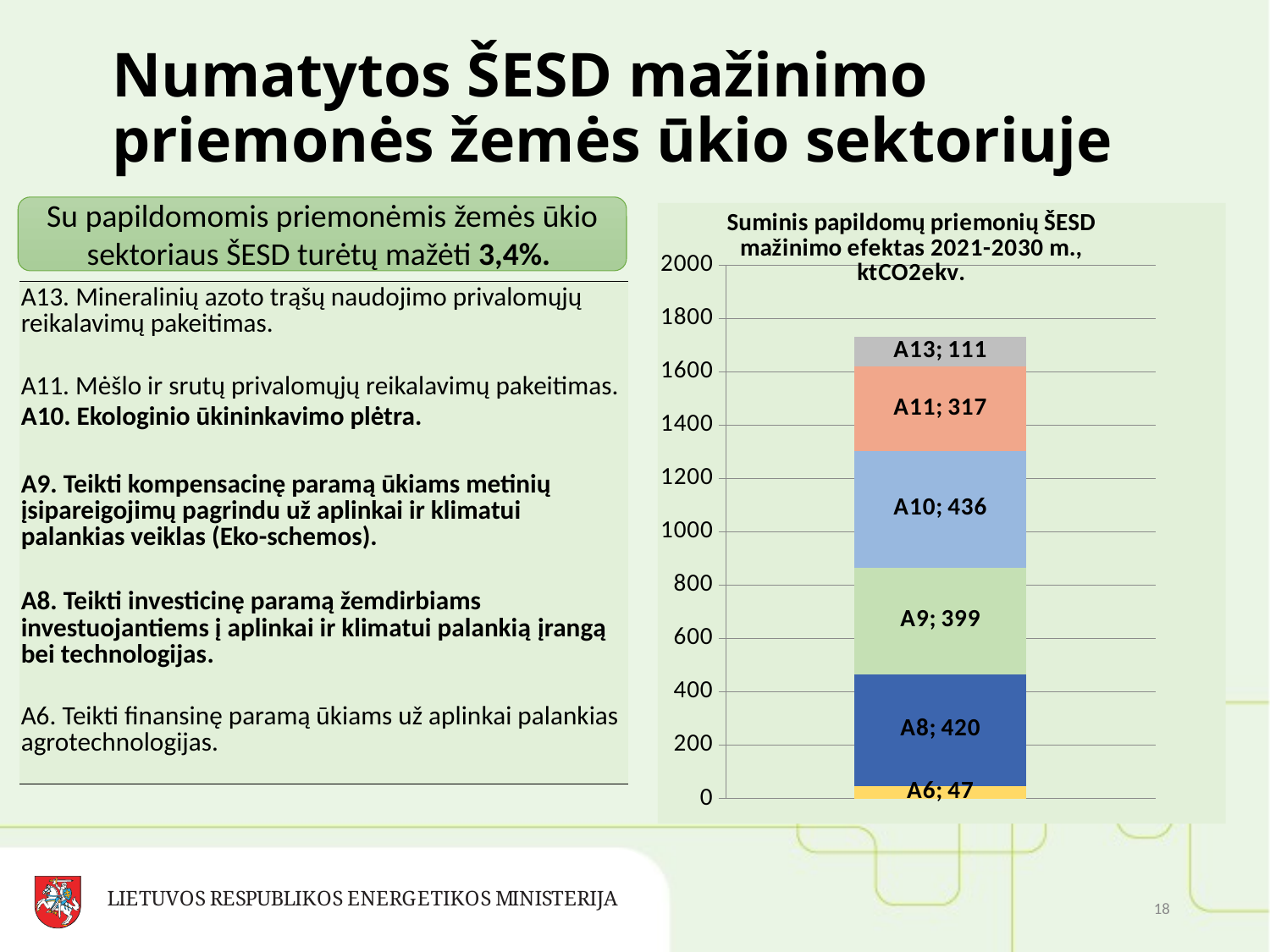
What is the value of the A11 segment in the stacked bar? 317 What is the value of the A13 segment in the stacked bar? 111 What is the value of the A6 segment in the stacked bar? 47 What is the title of the chart? Suminis papildomų priemonių ŠESD mažinimo efektas 2021-2030 m., ktCO2ekv. What is the difference between the A8 and A9 segment values? 21 Which segment of the stacked bar has the largest value? A10 What is the value of the A10 segment in the stacked bar? 436 How many segments make up the stacked bar? 6 What kind of chart is shown on the slide? Stacked bar chart Which segment has a larger value, A11 or A13? A11 What is the total of all segments in the stacked bar? 1730 Which segment of the stacked bar has the smallest value? A6